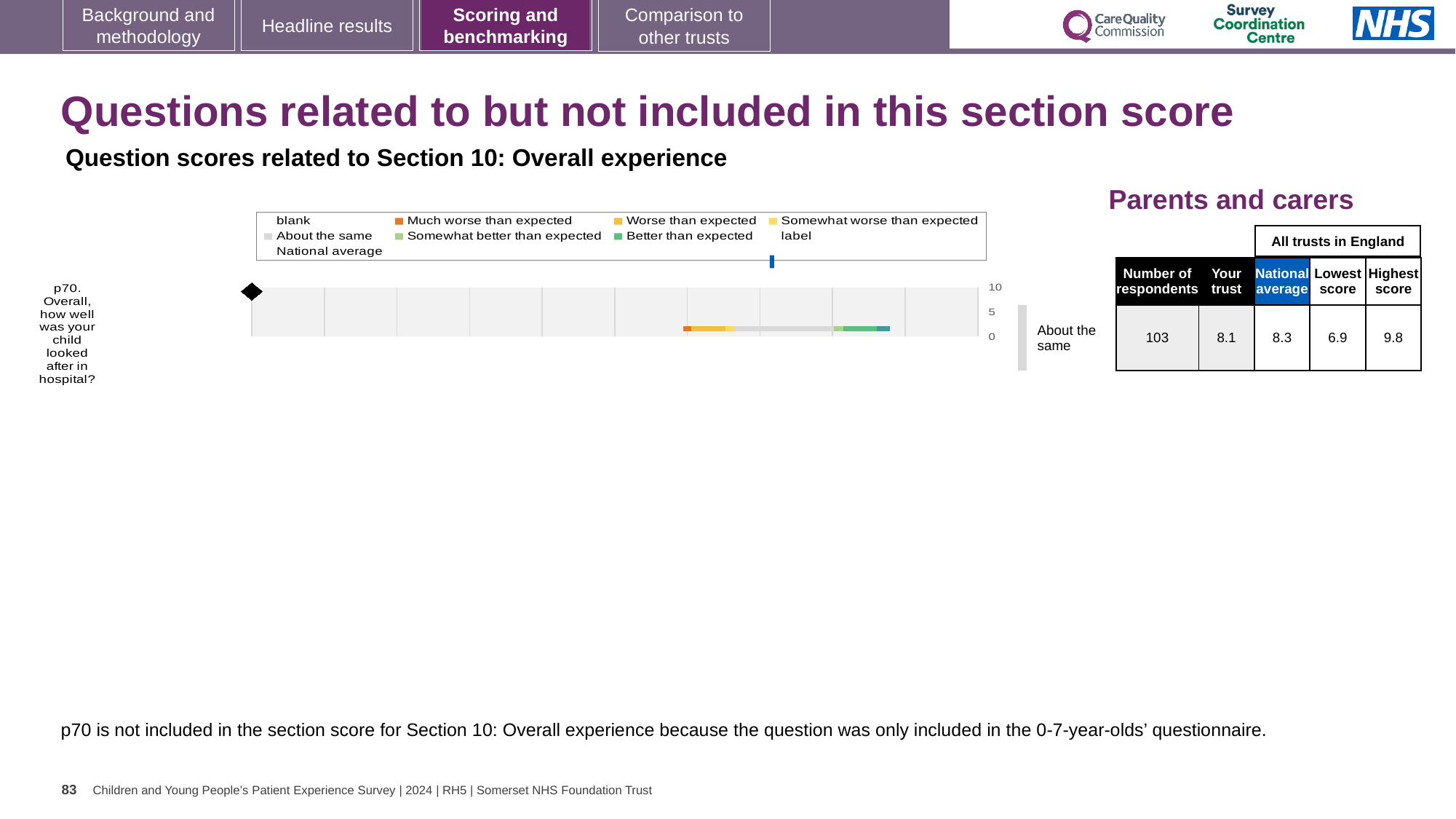
According to the table beside the chart, what is the lowest score among all trusts in England for p70? 6.9 What is the highest value shown on the chart's axis? 10 What kind of chart is shown on the slide? bar chart Is the 'Your trust' score for p70 larger or smaller than the national average? smaller How many survey questions are plotted in the chart? 1 What is the difference between the highest score and the lowest score for p70 in the table beside the chart? 2.9 Which question is plotted in the chart? p70. Overall, how well was your child looked after in hospital? According to the table beside the chart, what is the national average score for p70? 8.3 According to the table beside the chart, what is the highest score among all trusts in England for p70? 9.8 According to the table beside the chart, how many respondents answered p70? 103 What benchmark category label is shown to the right of the p70 bar? About the same According to the table beside the chart, what is the 'Your trust' score for p70? 8.1